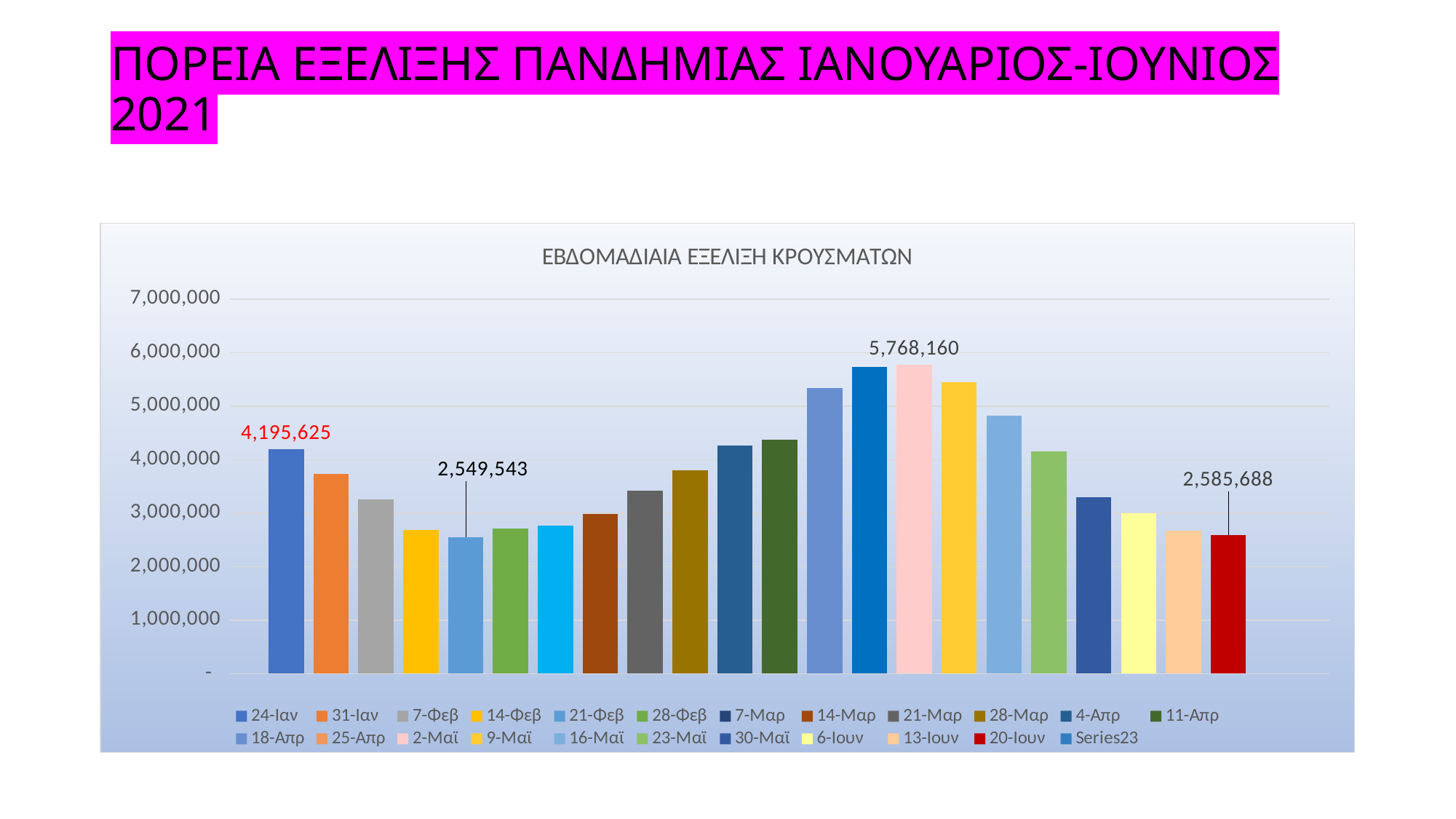
What is the difference between the values for 24-Ιαν and 20-Ιουν? 1,609,937 Is the value for 18-Απρ greater or less than 5,000,000? greater Which is larger, the value for 24-Ιαν or the value for 20-Ιουν? 24-Ιαν What is the value for 20-Ιουν? 2,585,688 Which week has the lowest value? 21-Φεβ How many bars are plotted in the chart? 22 What is the difference between the values for 2-Μαϊ and 21-Φεβ? 3,218,617 What is the value for 24-Ιαν? 4,195,625 What is the value for 21-Φεβ? 2,549,543 What type of chart is shown? Bar chart What is the value for 2-Μαϊ? 5,768,160 Is the value for 14-Φεβ greater or less than 3,000,000? less